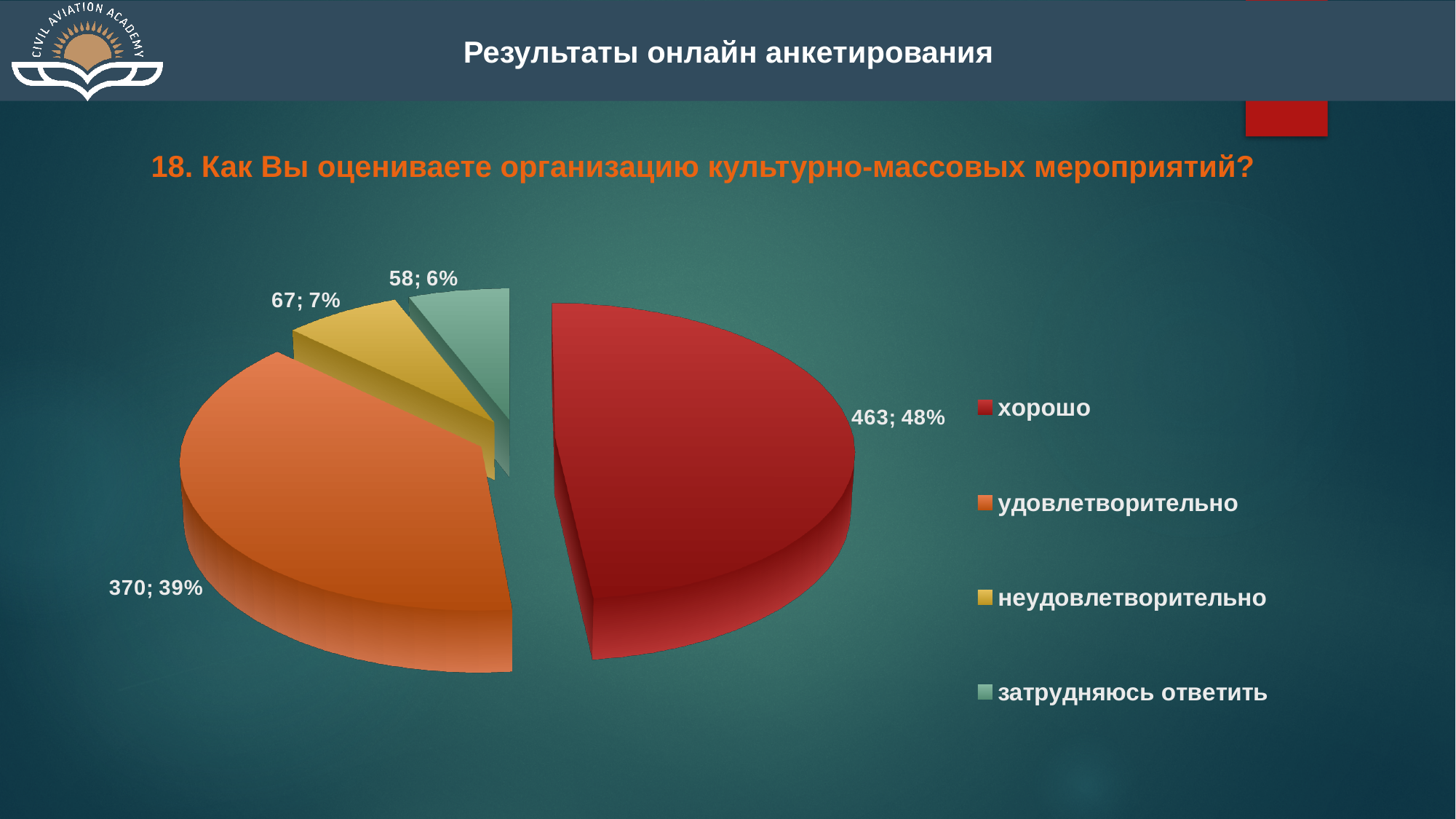
What is the count for "удовлетворительно"? 370 What kind of chart is shown on the slide? pie chart What share of the pie does "хорошо" represent? 48% Which category has the largest slice? хорошо What is the count for "хорошо"? 463 Which category has the smallest slice? затрудняюсь ответить What is the difference between the counts for "хорошо" and "удовлетворительно"? 93 What is the count for "затрудняюсь ответить"? 58 How many entries does the legend list? 4 How many slices does the pie chart have? 4 What is the count for "неудовлетворительно"? 67 What share of the pie does "удовлетворительно" represent? 39%